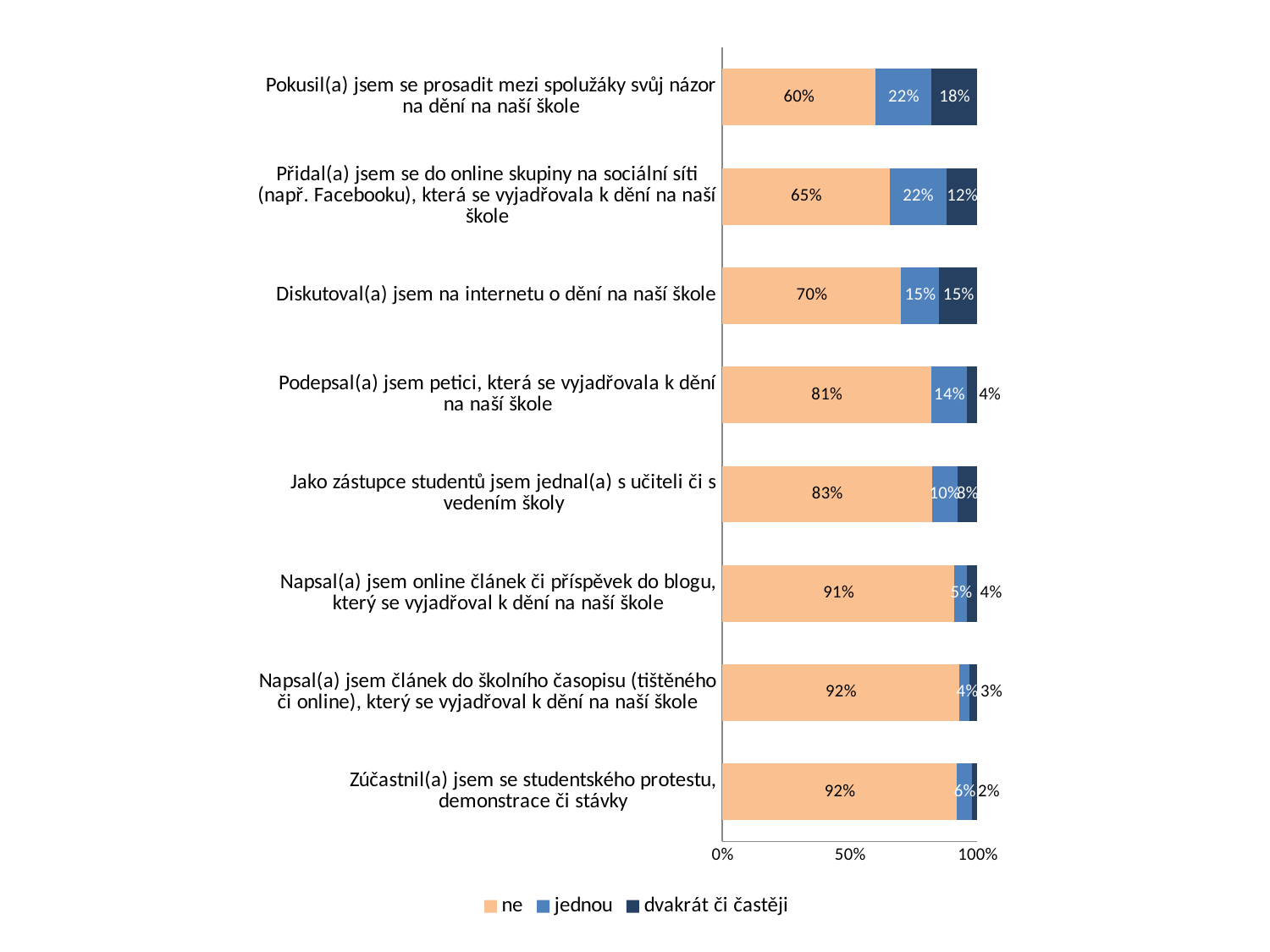
What is the difference between the "ne" values for "Přidal(a) jsem se do online skupiny na sociální síti (např. Facebooku), která se vyjadřovala k dění na naší škole" and "Pokusil(a) jsem se prosadit mezi spolužáky svůj názor na dění na naší škole"? 5% How many series does the legend list? 3 What kind of chart is shown on the slide? Stacked bar chart What is the value of the "ne" series for "Zúčastnil(a) jsem se studentského protestu, demonstrace či stávky"? 92% Which category has the lowest value for the "ne" series? Pokusil(a) jsem se prosadit mezi spolužáky svůj názor na dění na naší škole Which is larger: the "dvakrát či častěji" value for "Diskutoval(a) jsem na internetu o dění na naší škole" or for "Přidal(a) jsem se do online skupiny na sociální síti (např. Facebooku), která se vyjadřovala k dění na naší škole"? Diskutoval(a) jsem na internetu o dění na naší škole What is the value of the "dvakrát či častěji" series for "Pokusil(a) jsem se prosadit mezi spolužáky svůj názor na dění na naší škole"? 18% How many categories are shown in the chart? 8 What is the value of the "jednou" series for "Podepsal(a) jsem petici, která se vyjadřovala k dění na naší škole"? 14% What is the value of the "ne" series for "Diskutoval(a) jsem na internetu o dění na naší škole"? 70% Which category has the highest value for the "dvakrát či častěji" series? Pokusil(a) jsem se prosadit mezi spolužáky svůj názor na dění na naší škole What are the three legend entries of the chart? ne, jednou, dvakrát či častěji